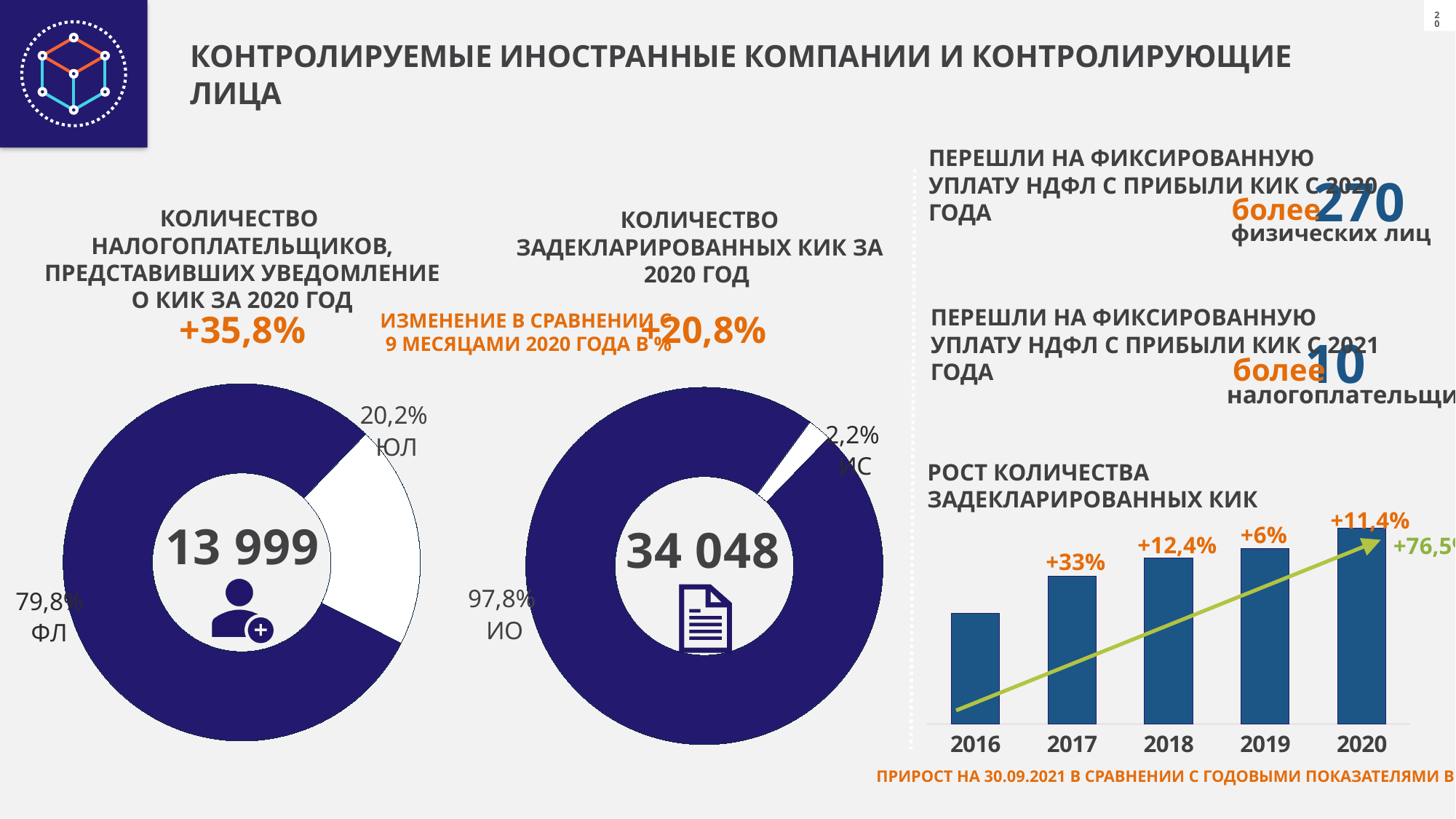
How many years are shown on the x axis of the bar chart РОСТ КОЛИЧЕСТВА ЗАДЕКЛАРИРОВАННЫХ КИК? 5 In the bar chart РОСТ КОЛИЧЕСТВА ЗАДЕКЛАРИРОВАННЫХ КИК, do the bars rise or fall from 2016 to 2020? rise In the bar chart РОСТ КОЛИЧЕСТВА ЗАДЕКЛАРИРОВАННЫХ КИК, which year has the tallest bar? 2020 In the middle donut chart, what share is labelled ИС? 2,2% In the left donut chart (КОЛИЧЕСТВО НАЛОГОПЛАТЕЛЬЩИКОВ, ПРЕДСТАВИВШИХ УВЕДОМЛЕНИЕ О КИК ЗА 2020 ГОД), what share is labelled ФЛ? 79,8% What total number is shown in the centre of the left donut chart? 13 999 In the left donut chart, what share is labelled ЮЛ? 20,2% In the bar chart РОСТ КОЛИЧЕСТВА ЗАДЕКЛАРИРОВАННЫХ КИК, what growth label is printed above the 2017 bar? +33% What kind of chart is the chart titled РОСТ КОЛИЧЕСТВА ЗАДЕКЛАРИРОВАННЫХ КИК? bar chart In the left donut chart, which segment is larger, ФЛ or ЮЛ? ФЛ What total number is shown in the centre of the middle donut chart? 34 048